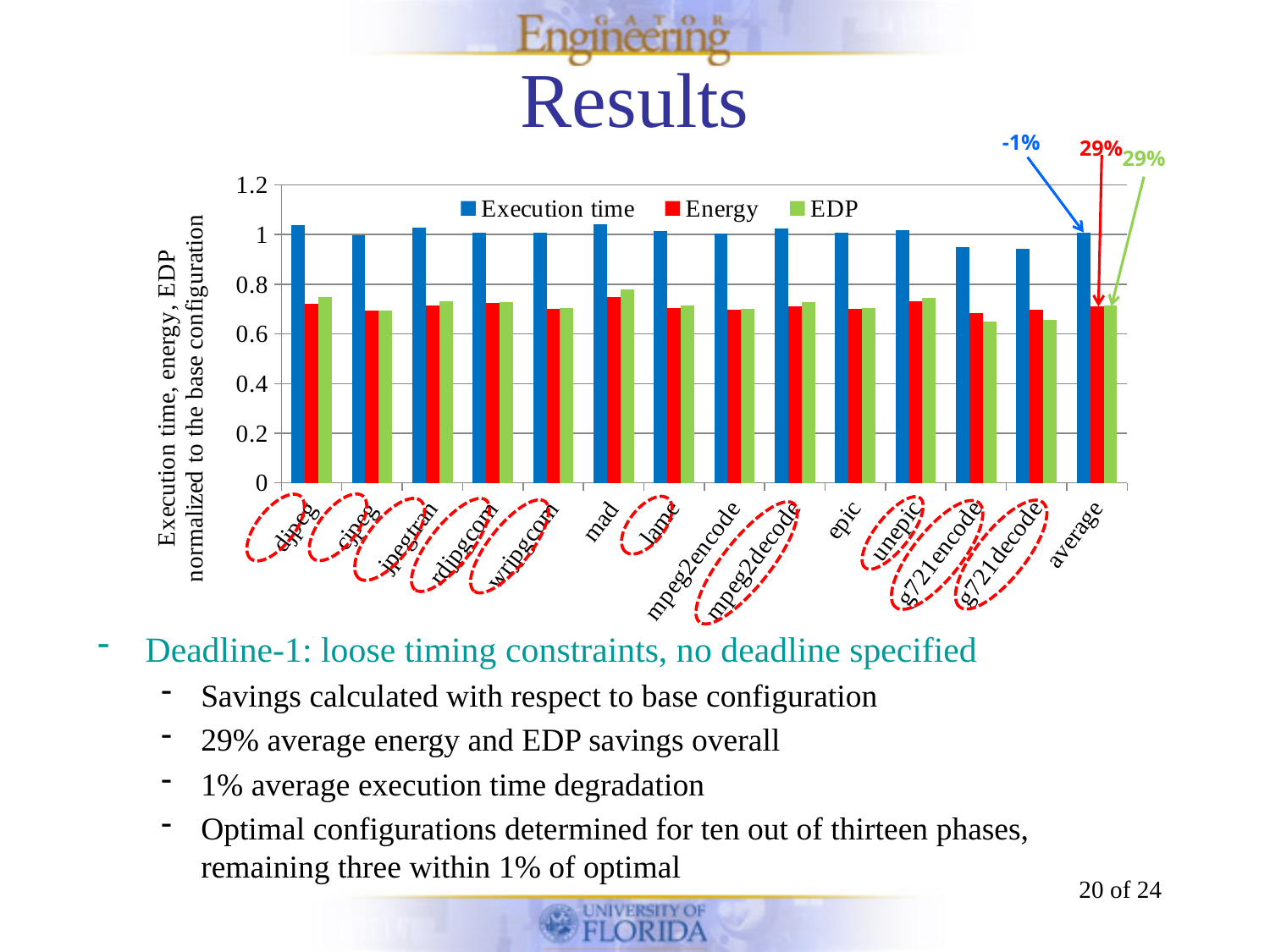
What percentage is annotated above the Energy bar for the average category? 29% For average, which is larger: the Execution time value or the EDP value? Execution time What kind of chart is shown on the slide? bar chart Is the EDP value for g721encode greater or less than 0.8? less Is the Energy value for cjpeg greater or less than 0.8? less Is the Execution time value for mad greater or less than 0.8? greater Which series are listed in the chart's legend? Execution time, Energy, EDP How many categories are shown along the x axis of the chart? 14 For djpeg, which is larger: the Execution time value or the Energy value? Execution time How many series does the chart's legend list? 3